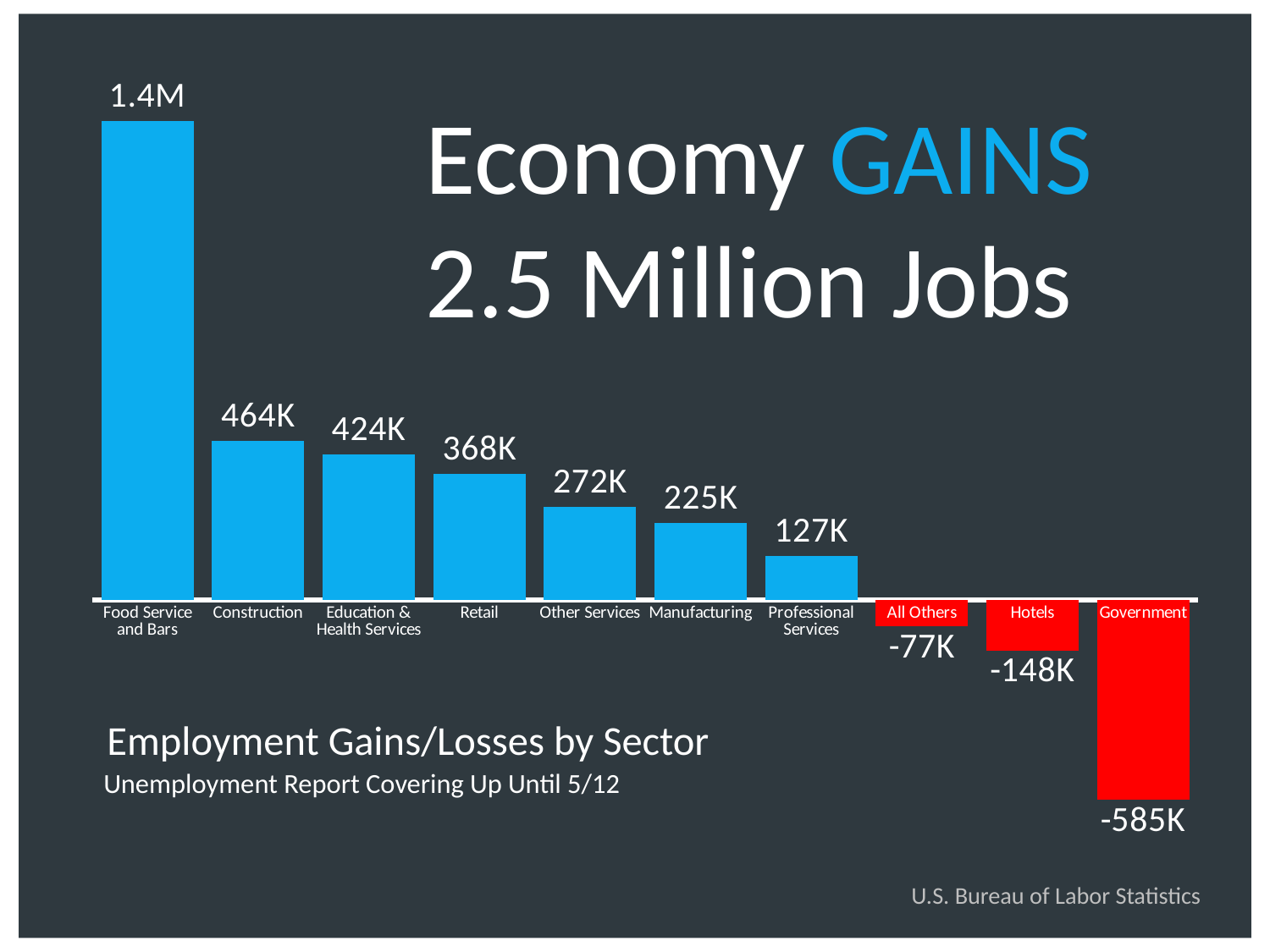
How many sectors are shown in the chart? 10 What is the value for Hotels? -148K What kind of chart is shown on the slide? Bar chart What is the value for Construction? 464K Do the values rise or fall from left to right across the chart? Fall Which is larger, the value for Manufacturing or the value for Professional Services? Manufacturing What is the difference between the values for Construction and Education & Health Services? 40K What is the value for Retail? 368K Which sector has the highest value? Food Service and Bars What is the value for Government? -585K What is the difference between the values for Retail and Other Services? 96K Which sector has the lowest value? Government